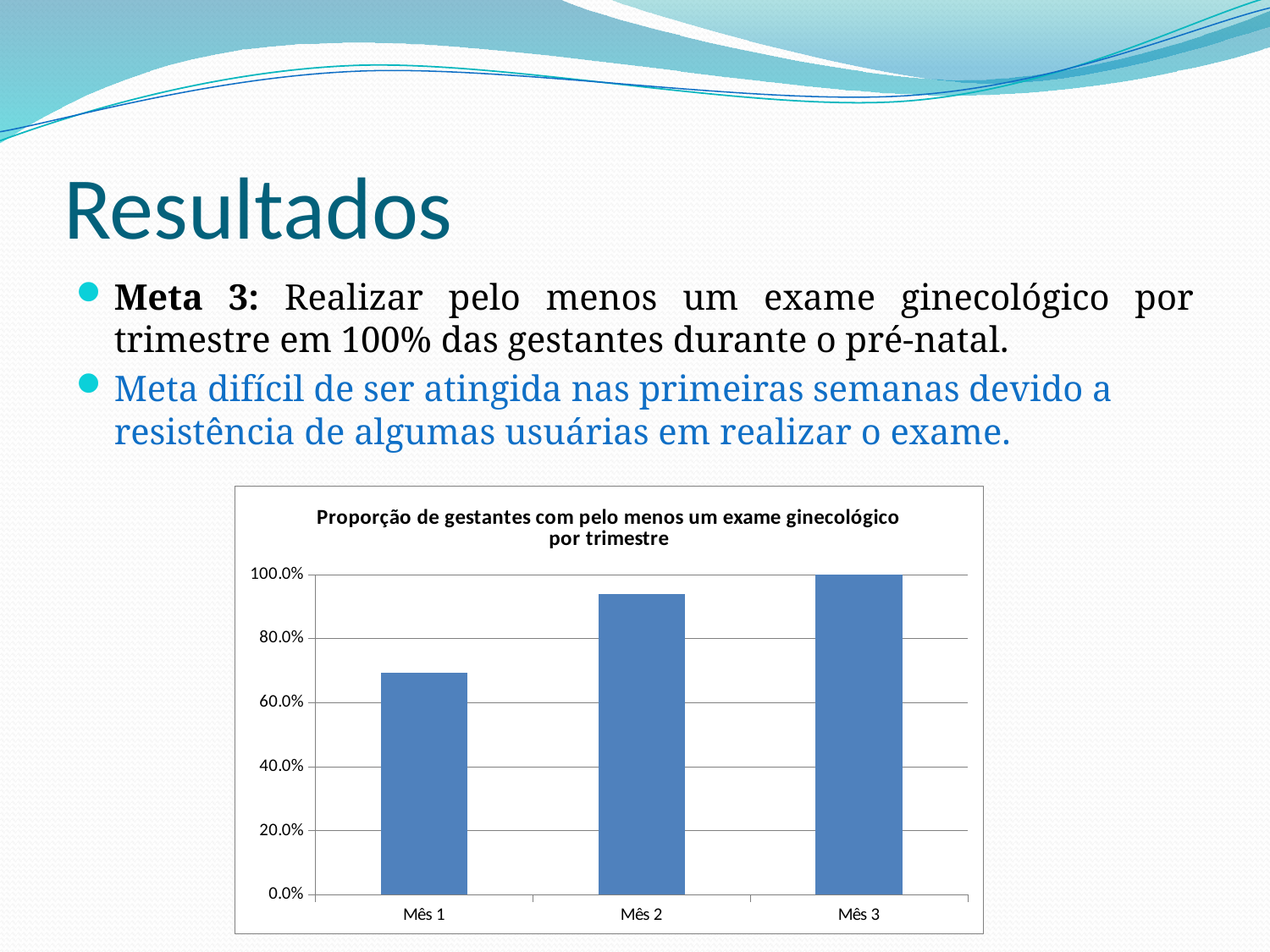
What is the value for Mês 3 in the chart? 100.0% What kind of chart is shown on the slide? bar chart Which is larger, the value for Mês 1 or the value for Mês 2? Mês 2 What is the highest value shown on the vertical axis of the chart? 100.0% Which month has the lowest proportion in the chart? Mês 1 How many categories (months) are plotted in the chart? 3 Do the values rise or fall from Mês 1 to Mês 3? rise What is the title of the chart? Proporção de gestantes com pelo menos um exame ginecológico por trimestre Is the value for Mês 2 greater or less than 80.0%? greater Which month has the highest proportion of pregnant women with at least one gynecological exam per trimester? Mês 3 Is the value for Mês 1 greater or less than 80.0%? less Is the value for Mês 1 greater or less than 60.0%? greater